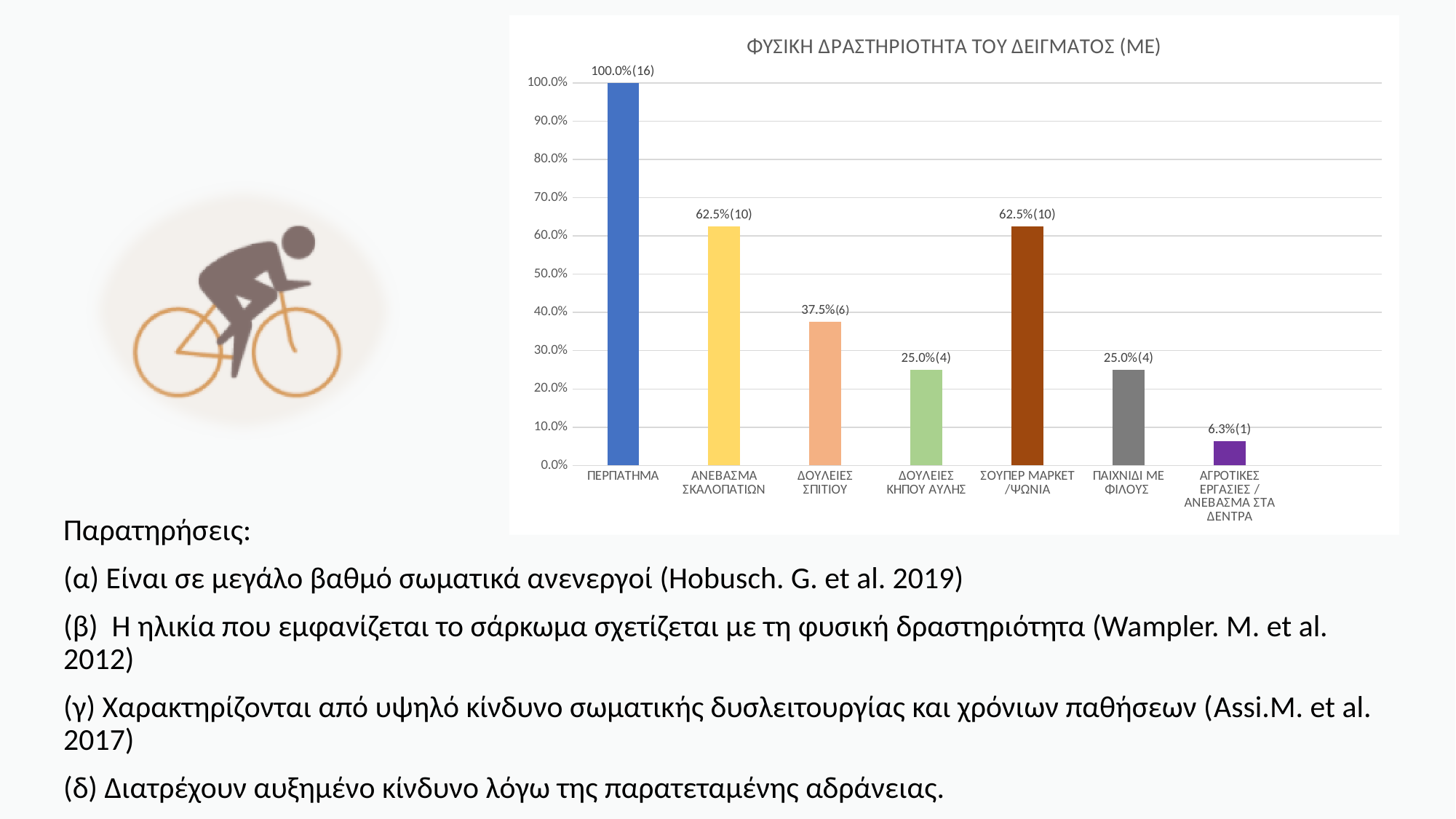
What is the value for ΠΕΡΠΑΤΗΜΑ? 100.0%(16) What kind of chart is shown on the slide? bar chart Is the value for ΣΟΥΠΕΡ ΜΑΡΚΕΤ /ΨΩΝΙΑ greater or less than 50.0%? greater Which category has the lowest value? ΑΓΡΟΤΙΚΕΣ ΕΡΓΑΣΙΕΣ / ΑΝΕΒΑΣΜΑ ΣΤΑ ΔΕΝΤΡΑ Which is larger, the value for ΔΟΥΛΕΙΕΣ ΣΠΙΤΙΟΥ or the value for ΠΑΙΧΝΙΔΙ ΜΕ ΦΙΛΟΥΣ? ΔΟΥΛΕΙΕΣ ΣΠΙΤΙΟΥ What is the value for ΔΟΥΛΕΙΕΣ ΣΠΙΤΙΟΥ? 37.5%(6) What is the difference in percentage between ΠΕΡΠΑΤΗΜΑ and ΑΝΕΒΑΣΜΑ ΣΚΑΛΟΠΑΤΙΩΝ? 37.5% What is the title of the chart? ΦΥΣΙΚΗ ΔΡΑΣΤΗΡΙΟΤΗΤΑ ΤΟΥ ΔΕΙΓΜΑΤΟΣ (ΜΕ) Which category has the highest value? ΠΕΡΠΑΤΗΜΑ What is the value for ΑΓΡΟΤΙΚΕΣ ΕΡΓΑΣΙΕΣ / ΑΝΕΒΑΣΜΑ ΣΤΑ ΔΕΝΤΡΑ? 6.3%(1) What colour is the bar for ΠΕΡΠΑΤΗΜΑ? blue How many categories are shown on the x axis? 7